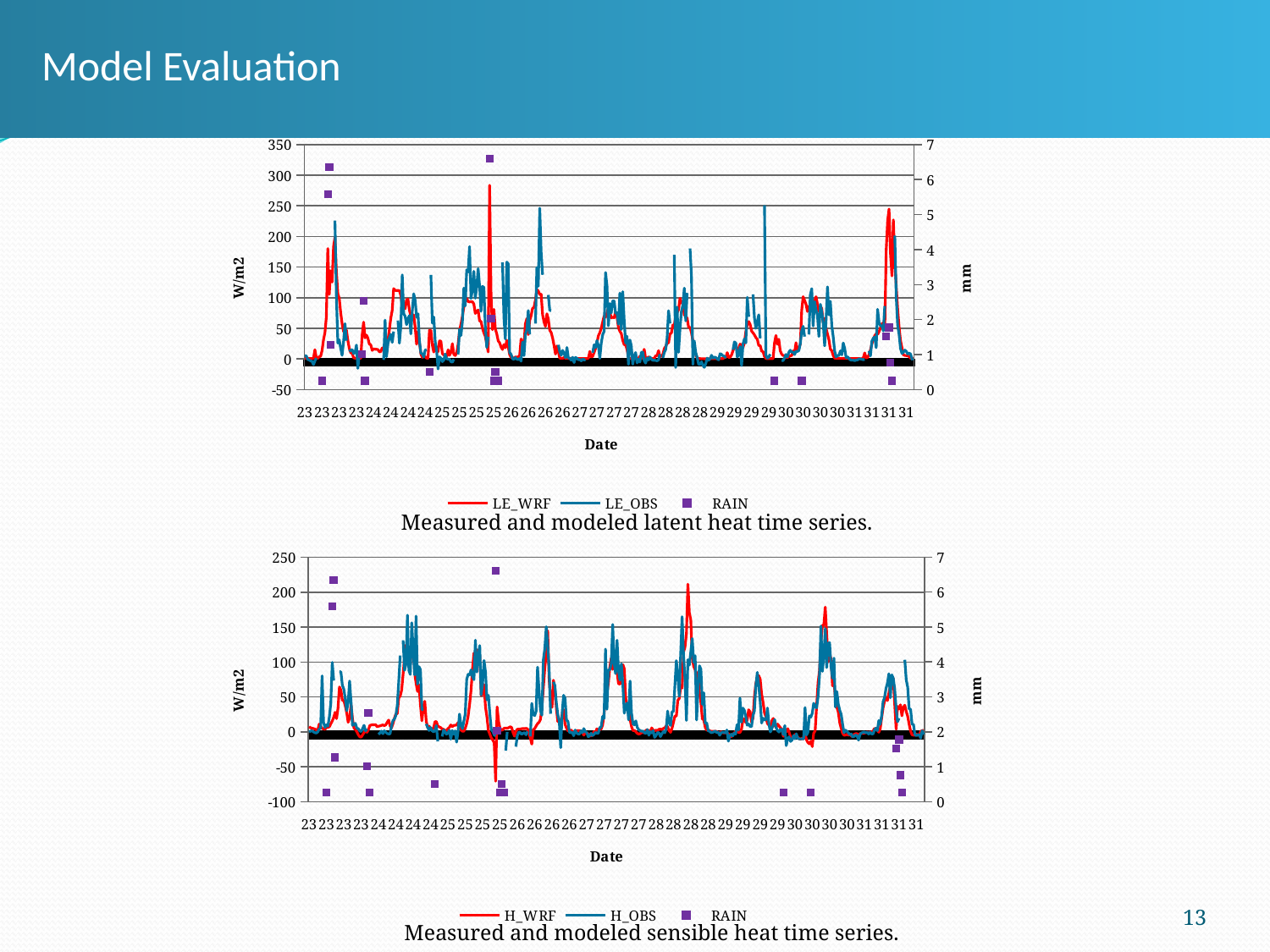
In the top chart (Measured and modeled latent heat time series), is the highest peak of the LE_WRF series greater or less than 250 W/m2? greater In the bottom chart (Measured and modeled sensible heat time series), is the highest RAIN marker greater or less than 6 mm? greater In the top chart (Measured and modeled latent heat time series), how many series does the legend list? 3 In the bottom chart (Measured and modeled sensible heat time series), is the highest peak of the H_WRF series greater or less than 150 W/m2? greater What kind of chart is the bottom chart (Measured and modeled sensible heat time series)? line chart What kind of chart is the top chart (Measured and modeled latent heat time series)? line chart In the top chart (Measured and modeled latent heat time series), which series is drawn in red according to the legend? LE_WRF In the bottom chart (Measured and modeled sensible heat time series), what is the title of the right-hand vertical axis? mm In the bottom chart (Measured and modeled sensible heat time series), how many series does the legend list? 3